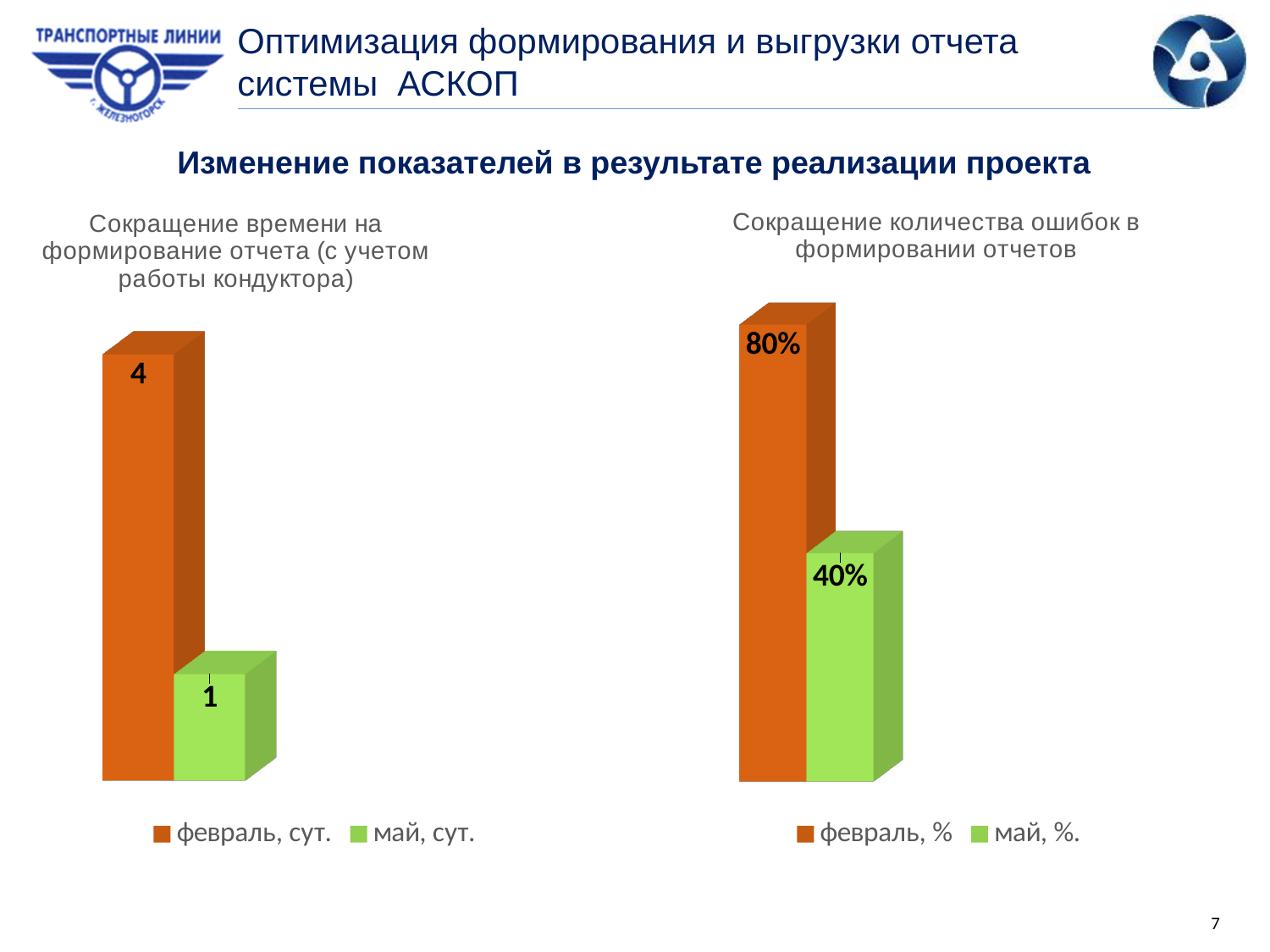
In the right chart (Сокращение количества ошибок в формировании отчетов), what is the value for февраль, %? 80% What is the title of the right chart? Сокращение количества ошибок в формировании отчетов In the left chart, what colour is the bar for май, сут.? green In the right chart (Сокращение количества ошибок в формировании отчетов), what is the value for май, %.? 40% In the left chart, what is the difference between the февраль and май values? 3 What kind of chart is the left chart? bar chart In the left chart (Сокращение времени на формирование отчета), what is the value for февраль, сут.? 4 In the right chart, what is the difference between the февраль and май values? 40% In the right chart, which series has the lower value? май, %. How many series does the legend of the right chart list? 2 In the left chart, which series has the higher value, февраль, сут. or май, сут.? февраль, сут. In the left chart (Сокращение времени на формирование отчета), what is the value for май, сут.? 1